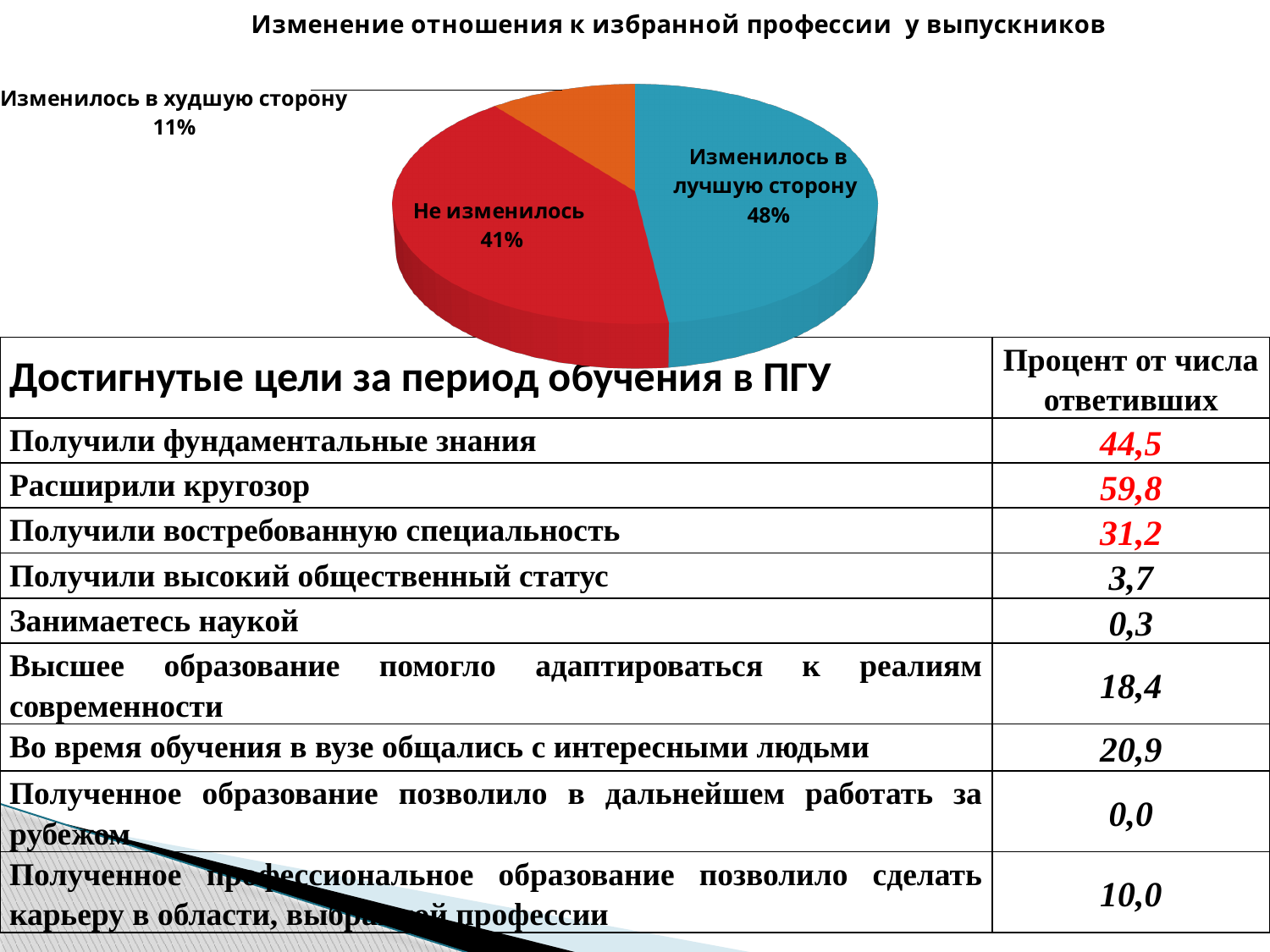
Which category has the largest slice of the pie chart? Изменилось в лучшую сторону What is the title of the pie chart? Изменение отношения к избранной профессии у выпускников What is the difference in percentage points between the "Изменилось в лучшую сторону" and "Не изменилось" slices? 7 What share of the pie is taken by the "Не изменилось" slice? 41% How many slices does the pie chart have? 3 What share of the pie chart is labelled "Изменилось в лучшую сторону"? 48% What percentage does the "Не изменилось" slice show? 41% What type of chart is shown on the slide? Pie chart What colour is the "Не изменилось" slice of the pie chart? Red Which is larger: the "Не изменилось" slice or the "Изменилось в худшую сторону" slice? Не изменилось What percentage does the "Изменилось в худшую сторону" slice show? 11% Which category has the smallest slice of the pie chart? Изменилось в худшую сторону